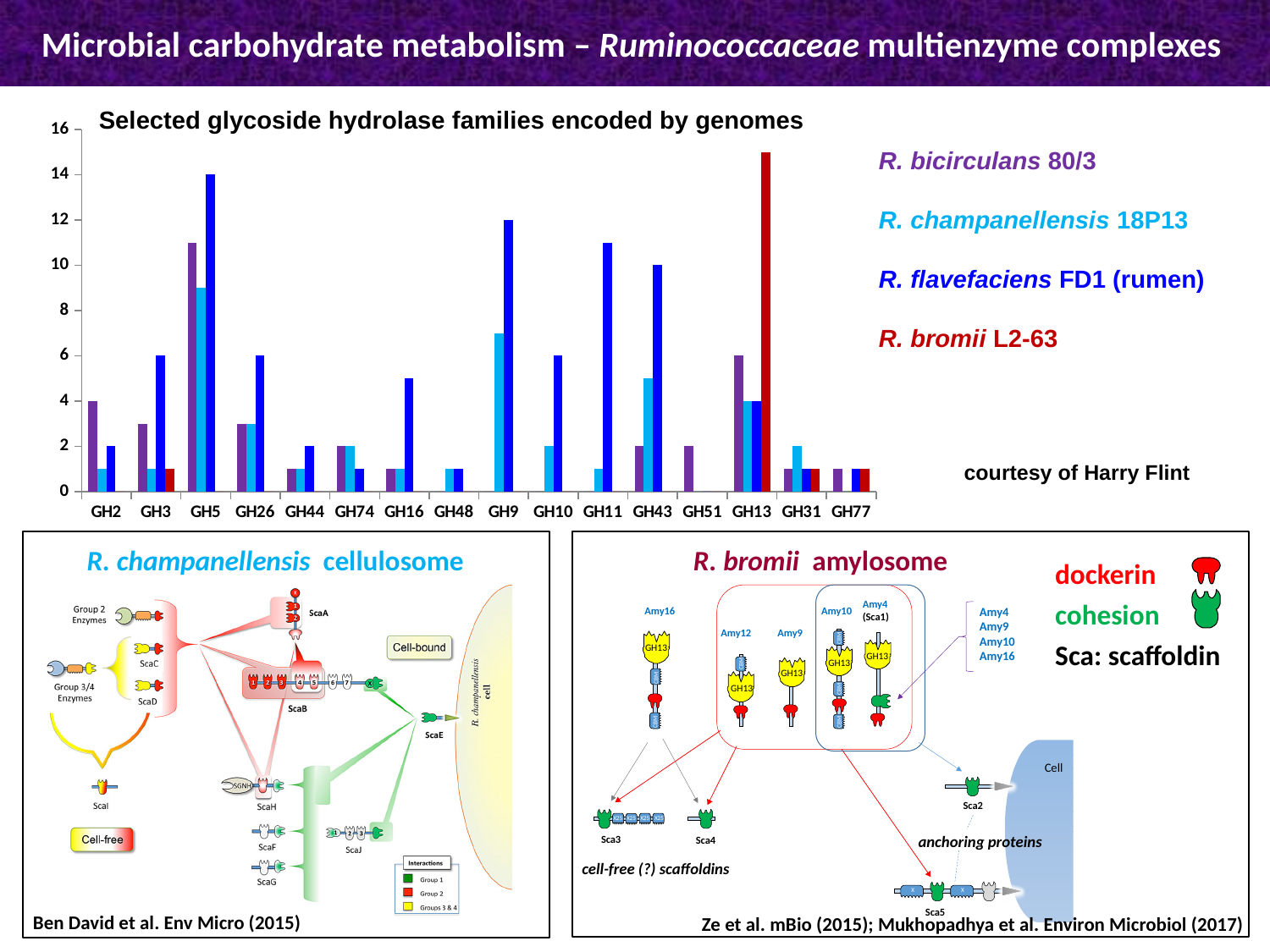
What type of chart is 'Selected glycoside hydrolase families encoded by genomes'? bar chart What is the difference between the R. flavefaciens FD1 (rumen) values for GH5 and GH9? 2 Which genome has the tallest bar in the chart, and in which family? R. bromii L2-63, GH13 What is the value for R. bicirculans 80/3 in family GH2? 4 Which colour represents R. bromii L2-63 in the chart? red What is the value for R. flavefaciens FD1 (rumen) in family GH5? 14 Is the value for R. flavefaciens FD1 (rumen) in GH11 greater or less than 10? greater How many glycoside hydrolase families (categories) are shown on the x axis of the chart? 16 Is the value for R. bromii L2-63 in GH13 greater or less than 14? greater For R. flavefaciens FD1 (rumen), which family has the larger value: GH5 or GH9? GH5 How many genomes (series) are listed in the chart's legend? 4 What is the value for R. flavefaciens FD1 (rumen) in family GH9? 12